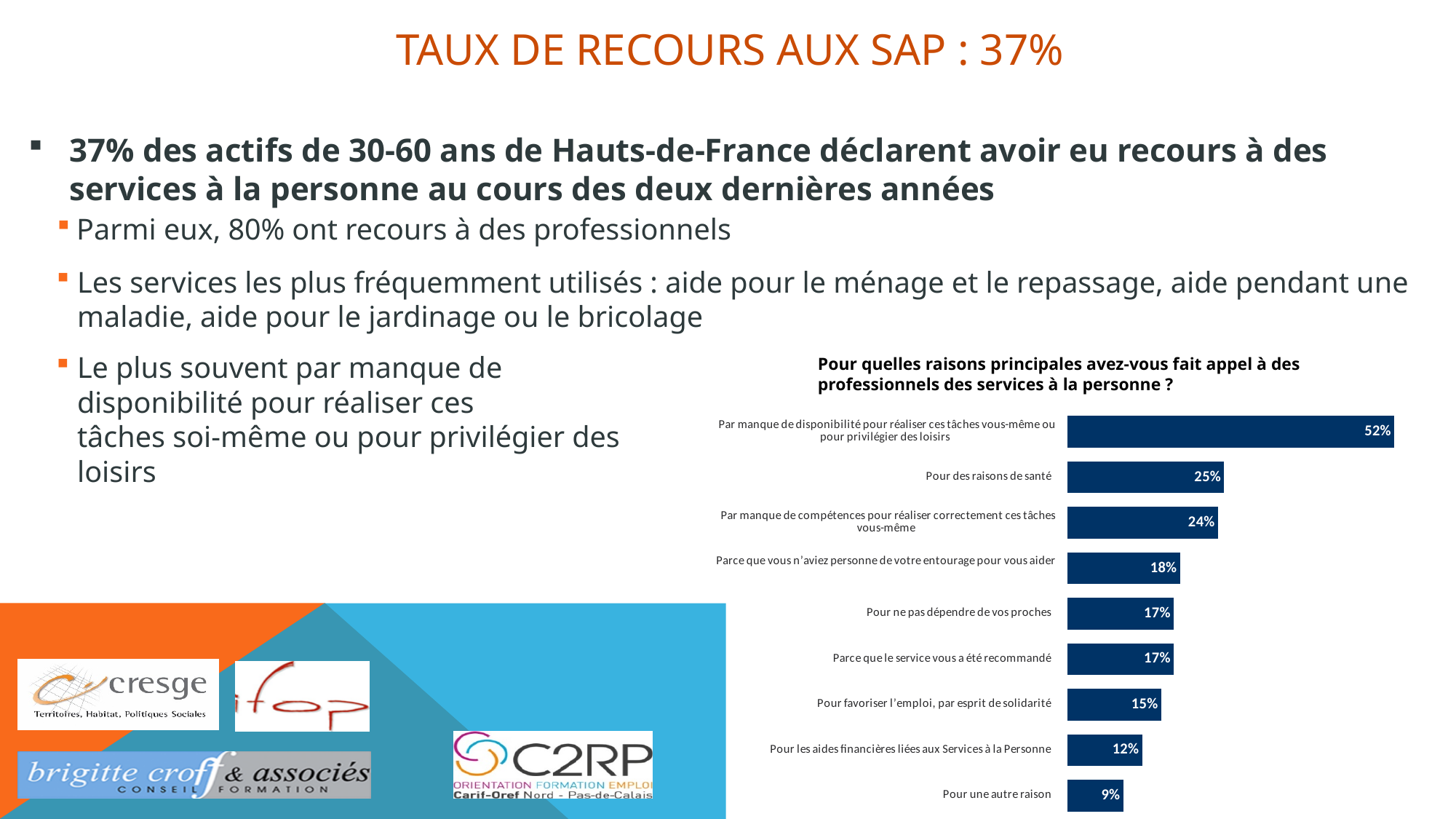
What kind of chart is shown on the slide? Bar chart What is the title of the chart? Pour quelles raisons principales avez-vous fait appel à des professionnels des services à la personne ? What is the value for "Pour les aides financières liées aux Services à la Personne"? 12% What is the difference between the value for "Par manque de disponibilité pour réaliser ces tâches vous-même ou pour privilégier des loisirs" and the value for "Pour des raisons de santé"? 27% What is the value for "Parce que le service vous a été recommandé"? 17% Which reason has the highest value? Par manque de disponibilité pour réaliser ces tâches vous-même ou pour privilégier des loisirs What is the value for "Pour des raisons de santé"? 25% Which reason has the lowest value? Pour une autre raison How many reasons (categories) are shown in the chart? 9 What is the value for "Parce que vous n'aviez personne de votre entourage pour vous aider"? 18% Which is larger: the value for "Par manque de compétences pour réaliser correctement ces tâches vous-même" or the value for "Pour ne pas dépendre de vos proches"? Par manque de compétences pour réaliser correctement ces tâches vous-même What is the difference between the value for "Pour favoriser l'emploi, par esprit de solidarité" and the value for "Pour une autre raison"? 6%